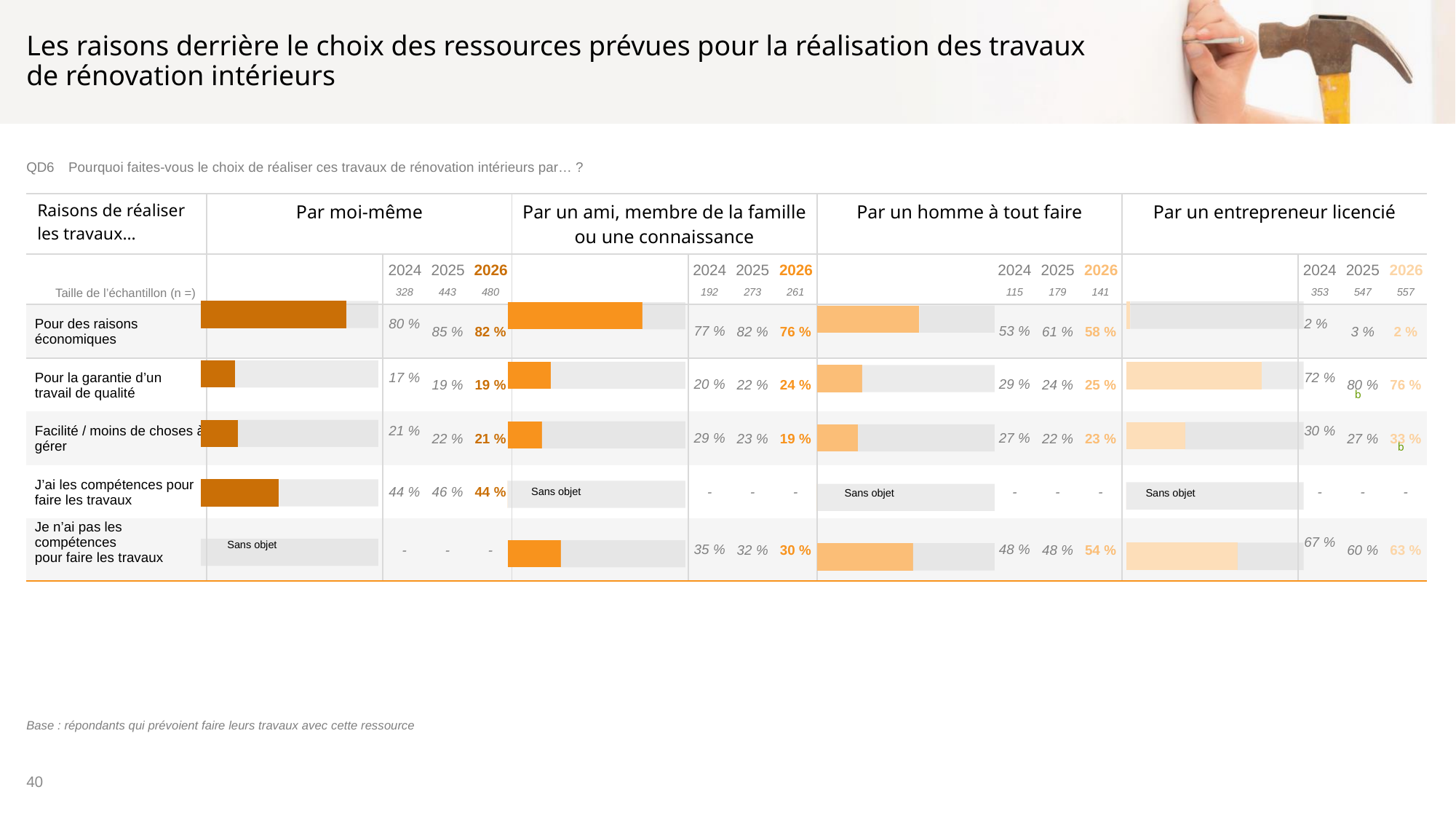
In the 'Par un homme à tout faire' chart, which is larger in 2026: 'Pour des raisons économiques' or 'Je n'ai pas les compétences pour faire les travaux'? Pour des raisons économiques In the 'Par moi-même' chart, what is the 2026 value for 'Pour des raisons économiques'? 82 % In the 'Par un ami, membre de la famille ou une connaissance' chart, which reason has the highest 2026 value? Pour des raisons économiques In the 'Par un ami, membre de la famille ou une connaissance' chart, what is the difference between the 2024 and 2026 values for 'Je n'ai pas les compétences pour faire les travaux'? 5 % In the 'Par moi-même' chart, what is the difference between the 2026 values for 'Pour des raisons économiques' and 'J'ai les compétences pour faire les travaux'? 38 % In the 'Par un ami, membre de la famille ou une connaissance' chart, do the values for 'Facilité / moins de choses à gérer' rise or fall from 2024 to 2026? fall In the 'Par un entrepreneur licencié' chart, what is the 2024 sample size (n)? 353 What kind of chart is used to show the 2026 values on this slide? bar chart In the 'Par un homme à tout faire' chart, what is the 2026 value for 'Je n'ai pas les compétences pour faire les travaux'? 54 % How many years of data are shown for each resource in the charts? 3 In the 'Par un entrepreneur licencié' chart, which reason has the lowest 2026 value? Pour des raisons économiques In the 'Par un entrepreneur licencié' chart, what is the 2025 value for 'Pour la garantie d'un travail de qualité'? 80 %